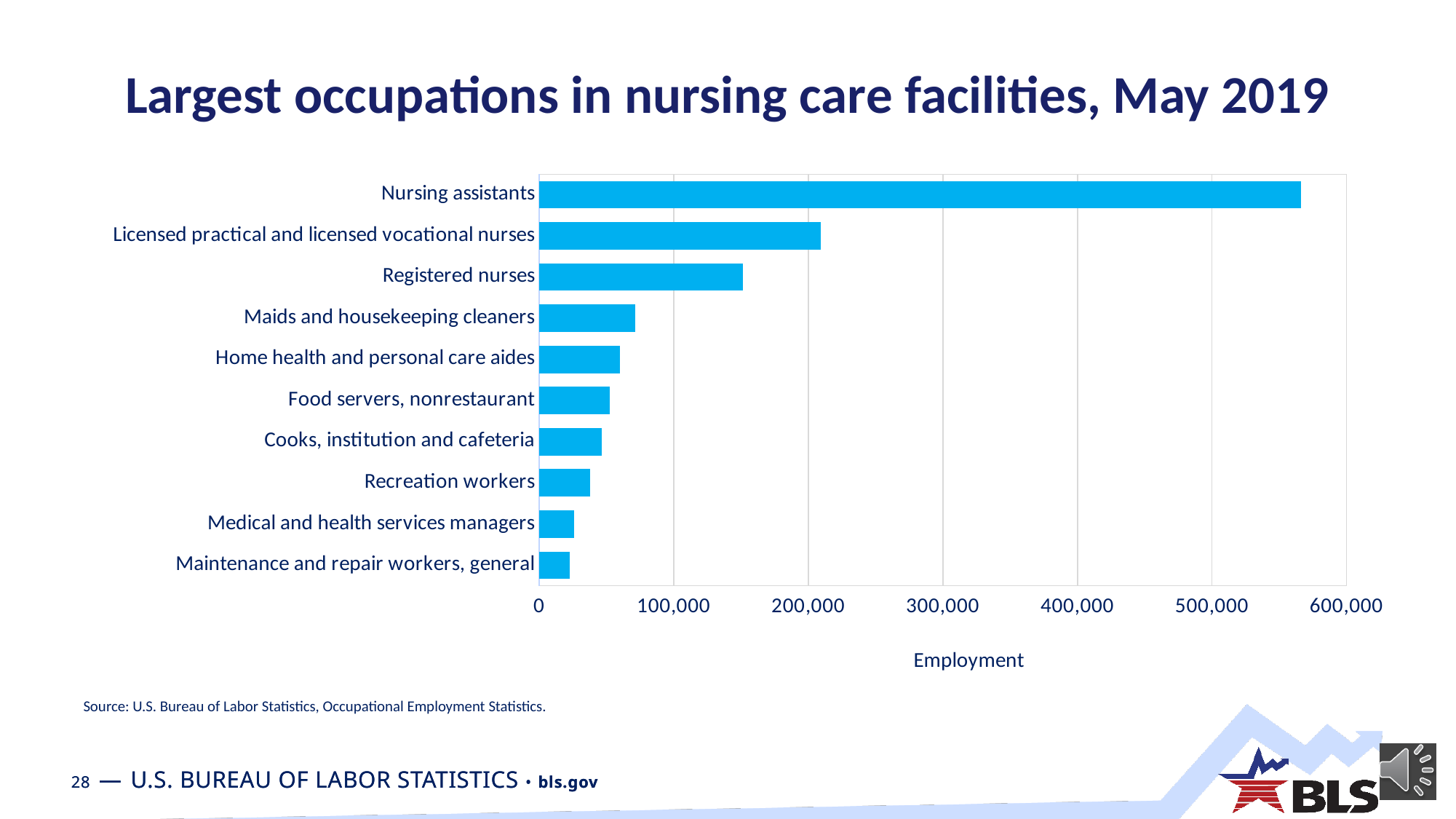
Which occupation has the highest employment in the chart? Nursing assistants How many occupations are shown in the chart? 10 Is the employment for Nursing assistants greater or less than 500,000? greater Which has higher employment, Recreation workers or Cooks, institution and cafeteria? Cooks, institution and cafeteria What is the title of the chart? Largest occupations in nursing care facilities, May 2019 Which has higher employment, Registered nurses or Licensed practical and licensed vocational nurses? Licensed practical and licensed vocational nurses Is the employment for Maids and housekeeping cleaners greater or less than 100,000? less Is the employment for Licensed practical and licensed vocational nurses greater or less than 200,000? greater What is the label on the horizontal axis of the chart? Employment Which occupation has the lowest employment in the chart? Maintenance and repair workers, general What kind of chart is shown on the slide? Bar chart